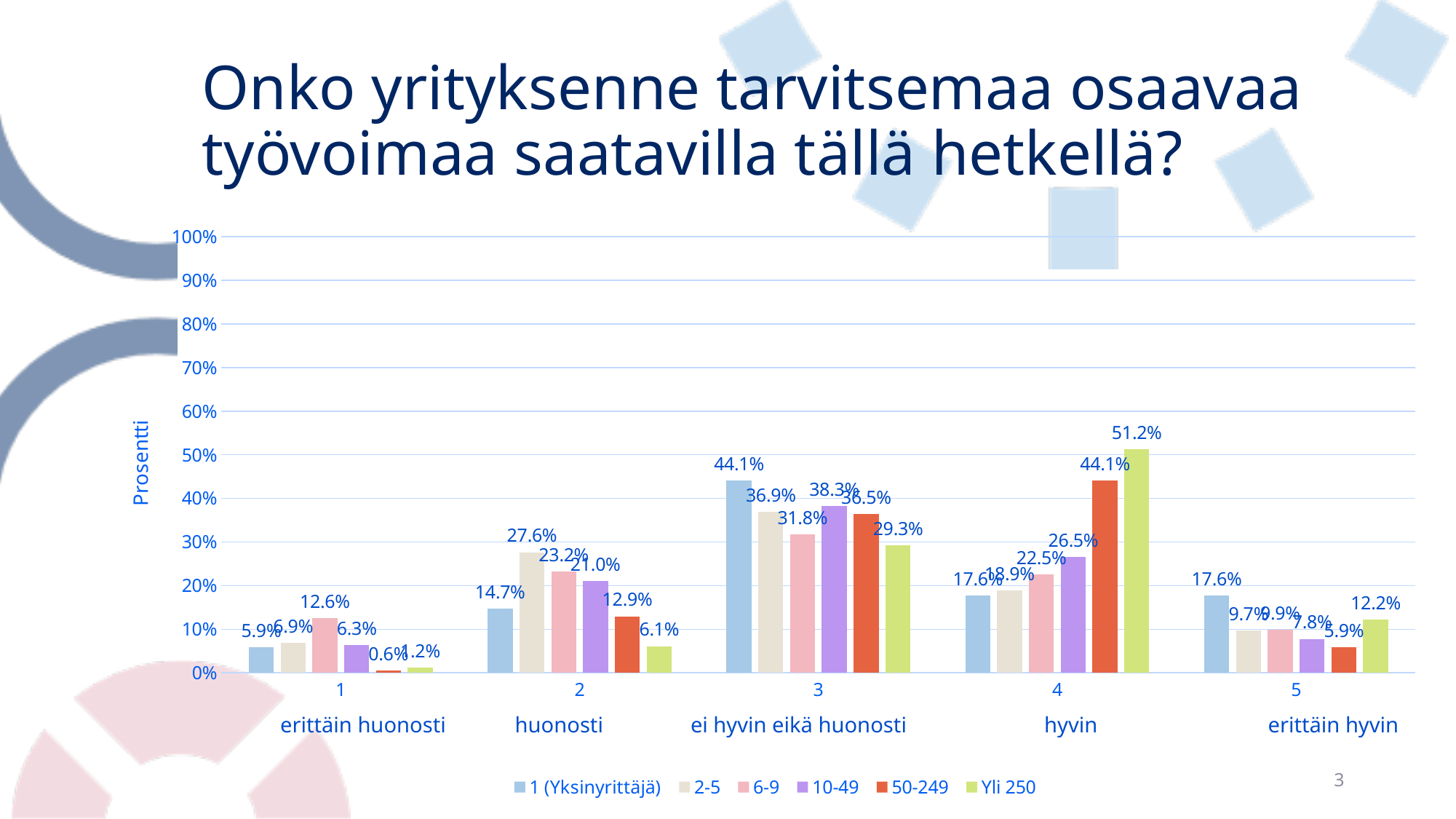
How many series does the legend list? 6 Which series has the lowest value in the 'erittäin huonosti' category? 50-249 What is the difference between the Yli 250 and 50-249 values in the 'hyvin' category? 7.1% What is the value for the 1 (Yksinyrittäjä) series in the 'ei hyvin eikä huonosti' category? 44.1% In the 'huonosti' category, which is larger: the 2-5 series or the 6-9 series? 2-5 What is the value for the Yli 250 series in the 'hyvin' category? 51.2% Is the value for the 10-49 series in the 'ei hyvin eikä huonosti' category greater or less than 30%? greater In which category does the Yli 250 series reach its highest value? hyvin What kind of chart is shown on the slide? bar chart What is the value for the 50-249 series in the 'huonosti' category? 12.9% What is the label of the y axis? Prosentti How many categories are shown on the x axis? 5